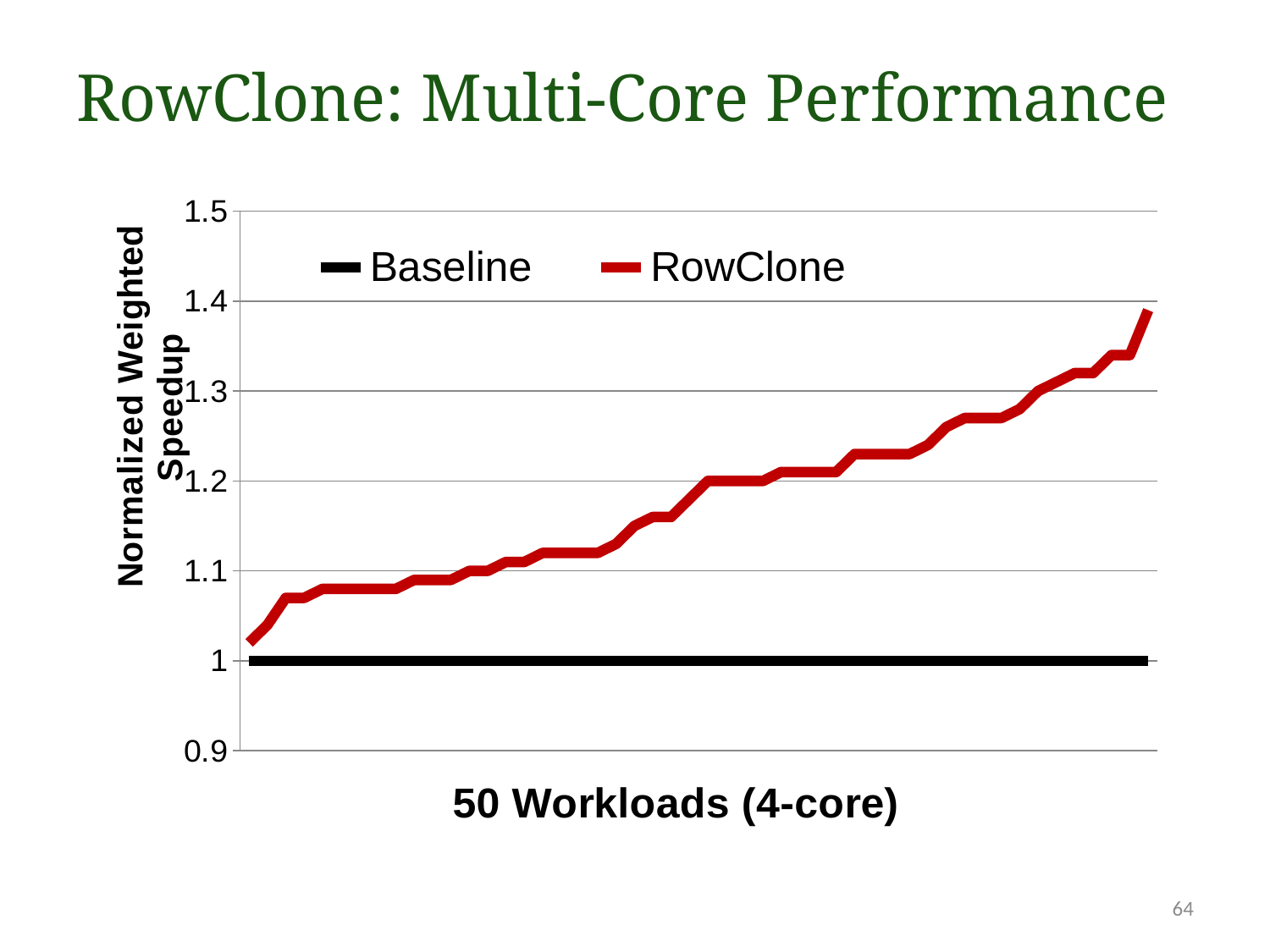
What are the two series named in the legend? Baseline and RowClone Is the lowest RowClone value greater or less than 1.1? less Which series has higher values, Baseline or RowClone? RowClone What kind of chart is shown on the slide? line chart Is the lowest RowClone value greater or less than 1? greater How many series does the legend list? 2 How many workloads are plotted along the x axis? 50 What is the label of the y axis? Normalized Weighted Speedup Does the RowClone series rise or fall from left to right along the x axis? rise What is the value of the Baseline series across the workloads? 1 What is the title of the slide's chart? RowClone: Multi-Core Performance Is the highest RowClone value greater or less than 1.3? greater